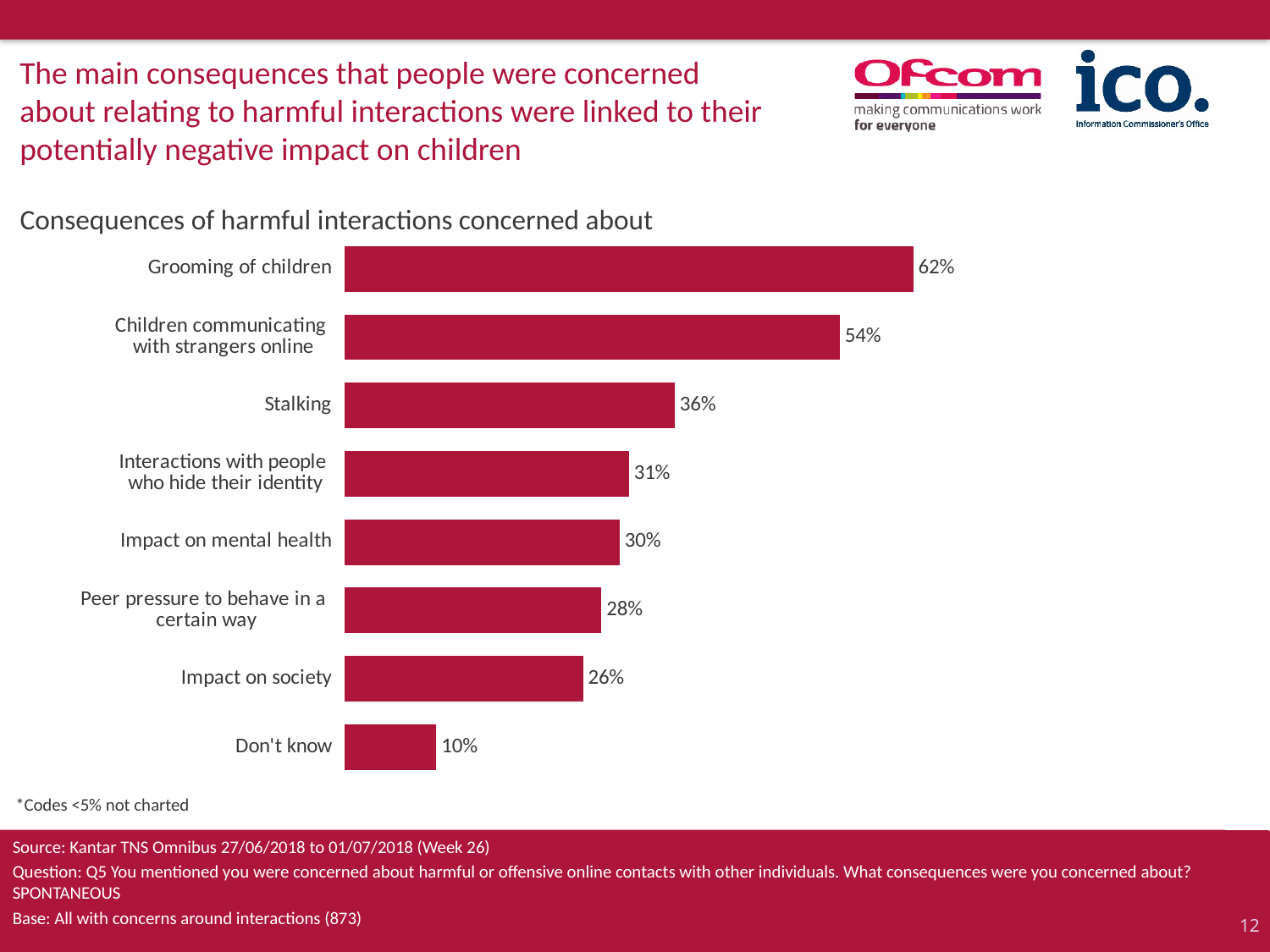
Which consequence has the highest percentage? Grooming of children What is the difference in percentage points between Grooming of children and Children communicating with strangers online? 8 What colour are the bars in the chart? Red What is the difference between Stalking and Impact on mental health? 6 What kind of chart is shown on the slide? Bar chart What is the title of the chart? Consequences of harmful interactions concerned about Which is larger: Interactions with people who hide their identity or Peer pressure to behave in a certain way? Interactions with people who hide their identity How many categories are plotted in the chart? 8 What percentage of respondents were concerned about grooming of children? 62% Which category has the lowest percentage? Don't know What percentage is shown for Impact on society? 26% What is the value shown for Stalking? 36%